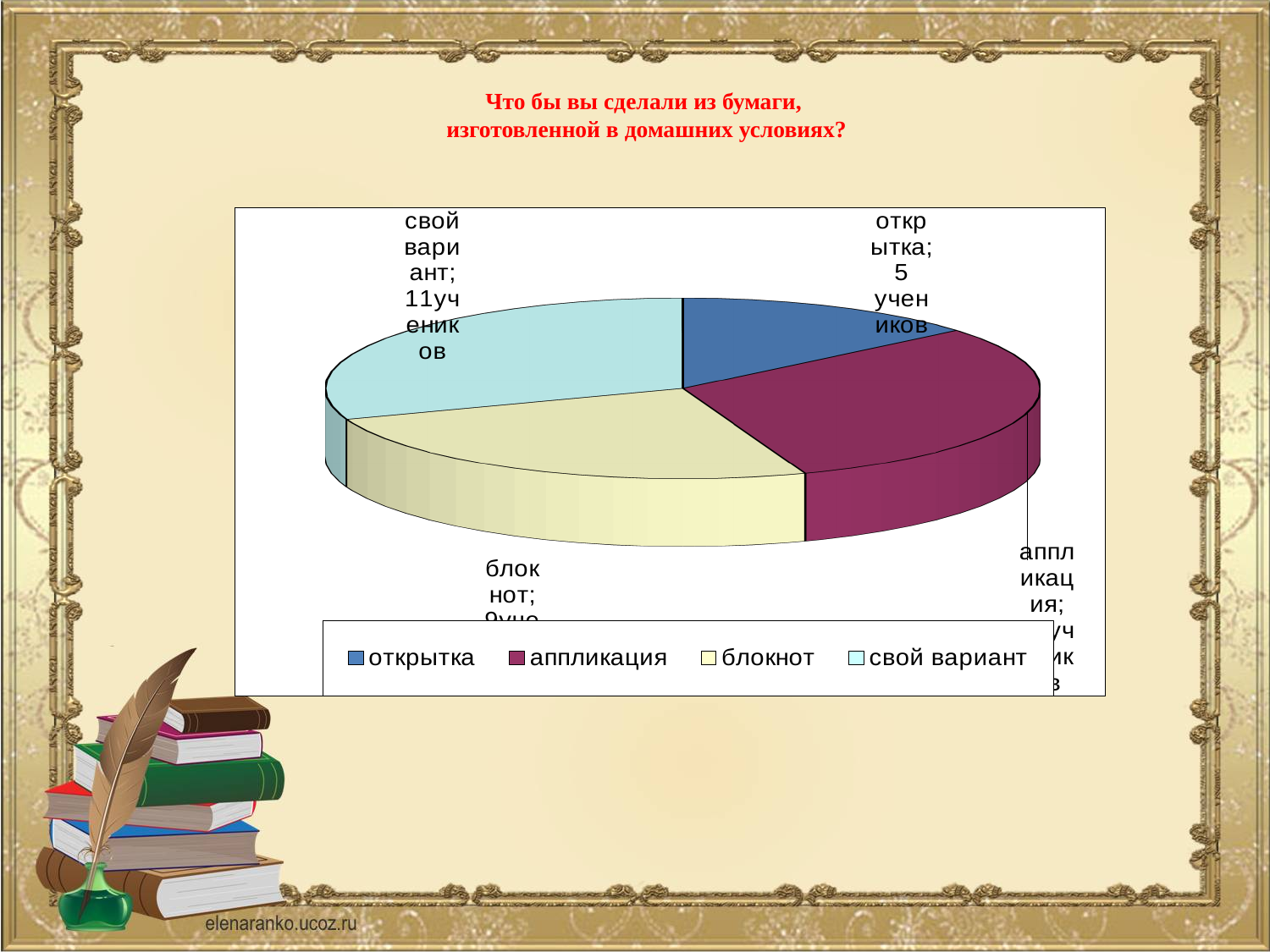
How many учеников chose «блокнот» according to the pie chart label? 9 учеников Which slice is larger: «свой вариант» or «открытка»? свой вариант What is the title of the chart on the slide? Что бы вы сделали из бумаги, изготовленной в домашних условиях? What colour is the «открытка» slice in the pie chart? blue Which slice is larger: «блокнот» or «открытка»? блокнот Which category has the smallest slice in the pie chart? открытка How many учеников chose «открытка» according to the pie chart label? 5 учеников How many categories does the legend of the pie chart list? 4 What kind of chart is shown on the slide? pie chart How many учеников chose «свой вариант» according to the pie chart label? 11 учеников What is the difference between the number of учеников for «свой вариант» and for «открытка»? 6 учеников